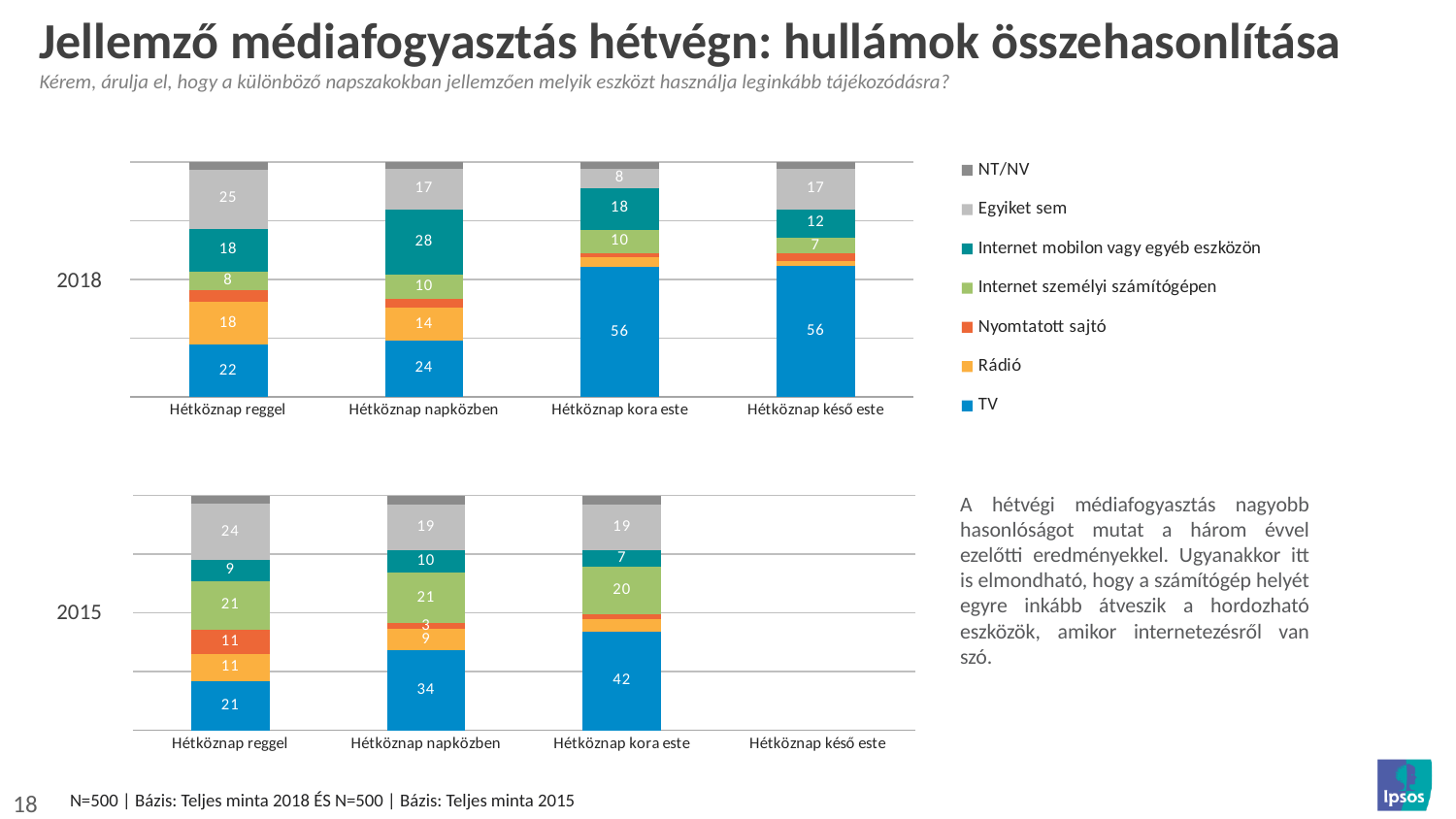
In the 2015 chart, what is the Egyiket sem value for Hétköznap reggel? 24 In the 2018 chart, what is the value for Internet mobilon vagy egyéb eszközön for Hétköznap napközben? 28 In the 2015 chart, which is larger for Hétköznap reggel: the TV value or the Internet mobilon vagy egyéb eszközön value? TV In the 2015 chart, what is the Internet személyi számítógépen value for Hétköznap kora este? 20 How many series does the legend list? 7 In the 2018 chart, what is the TV value for Hétköznap kora este? 56 In the 2018 chart, what is the difference between the TV values for Hétköznap kora este and Hétköznap reggel? 34 In the 2018 chart, which time of day has the highest TV value? Hétköznap kora este and Hétköznap késő este (both 56) What kind of chart is the 2018 chart? Stacked bar chart In the 2018 chart, what is the Rádió value for Hétköznap reggel? 18 In the 2015 chart, what is the TV value for Hétköznap napközben? 34 In the 2015 chart, how many time-of-day categories have a bar plotted? 3